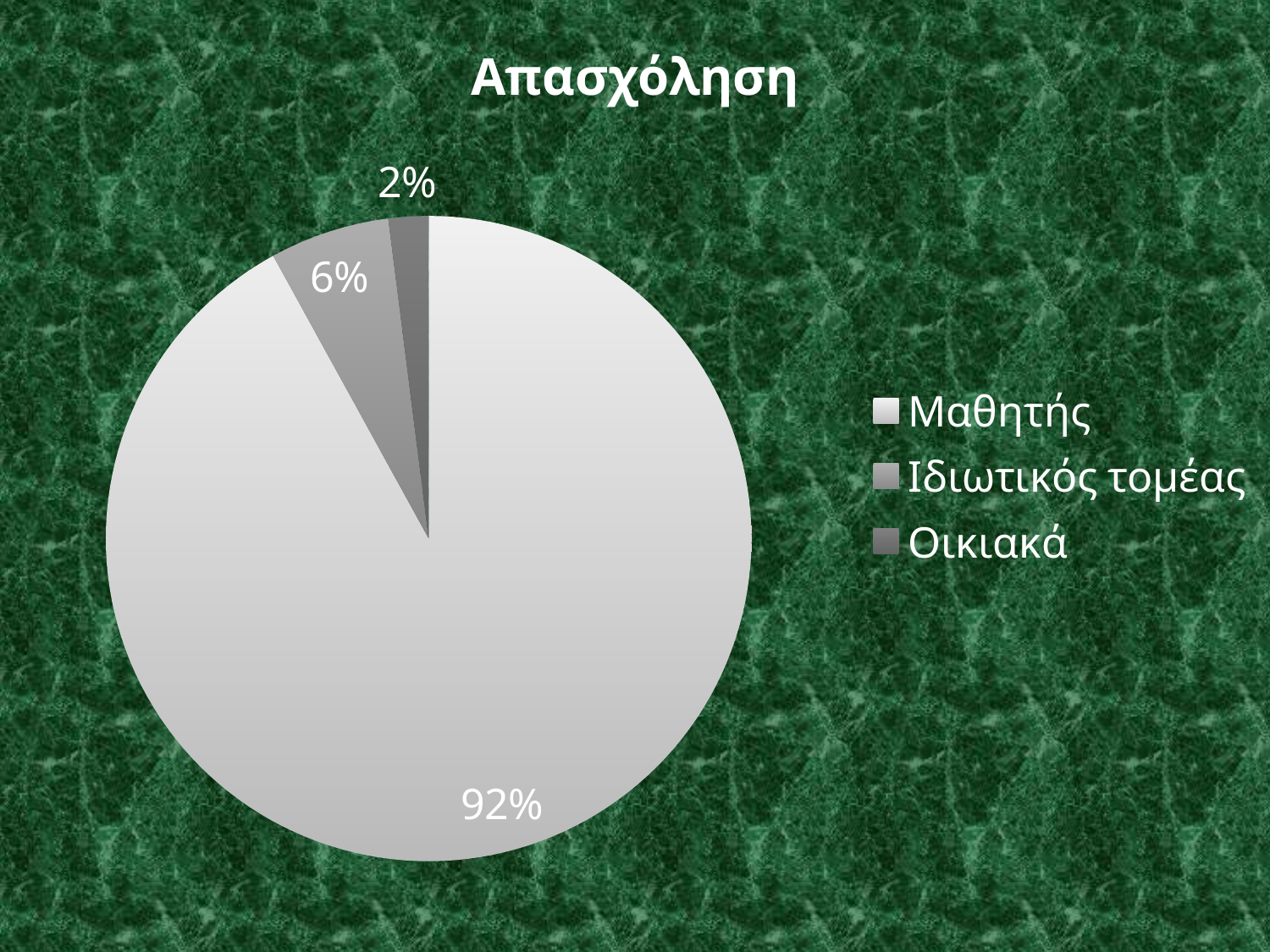
Which category has the largest slice of the pie? Μαθητής What share of the pie does Οικιακά take? 2% Which category has the smallest slice of the pie? Οικιακά What share of the pie does Μαθητής take? 92% What is the title of the chart? Απασχόληση What is the difference in percentage points between Μαθητής and Ιδιωτικός τομέας? 86 How many entries does the legend list? 3 What kind of chart is shown on the slide? pie chart What is the difference in percentage points between Ιδιωτικός τομέας and Οικιακά? 4 What share of the pie does Ιδιωτικός τομέας take? 6% Which is larger, the slice for Ιδιωτικός τομέας or the slice for Οικιακά? Ιδιωτικός τομέας How many categories does the pie chart show? 3